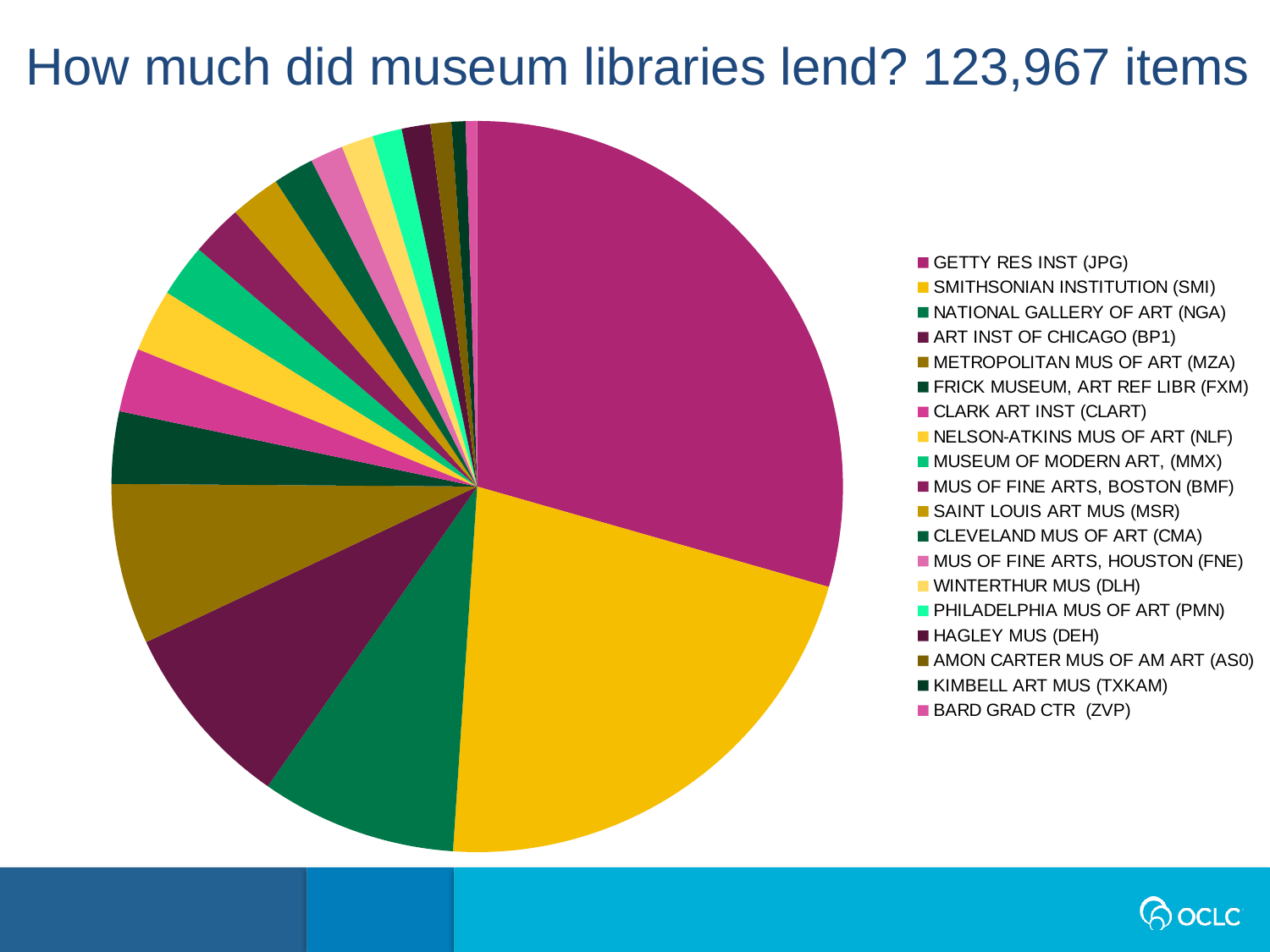
Which slice is larger: ART INST OF CHICAGO (BP1) or FRICK MUSEUM, ART REF LIBR (FXM)? ART INST OF CHICAGO (BP1) Which museum library has the largest slice of the pie? GETTY RES INST (JPG) Which legend entry is listed first in the chart's legend? GETTY RES INST (JPG) Which slice is larger: METROPOLITAN MUS OF ART (MZA) or CLARK ART INST (CLART)? METROPOLITAN MUS OF ART (MZA) How many museum libraries are listed in the chart's legend? 19 What kind of chart is shown on the slide? pie chart Which slice is larger: GETTY RES INST (JPG) or SMITHSONIAN INSTITUTION (SMI)? GETTY RES INST (JPG) According to the slide title, how many items in total did museum libraries lend? 123,967 items Which museum library has the second-largest slice of the pie? SMITHSONIAN INSTITUTION (SMI)